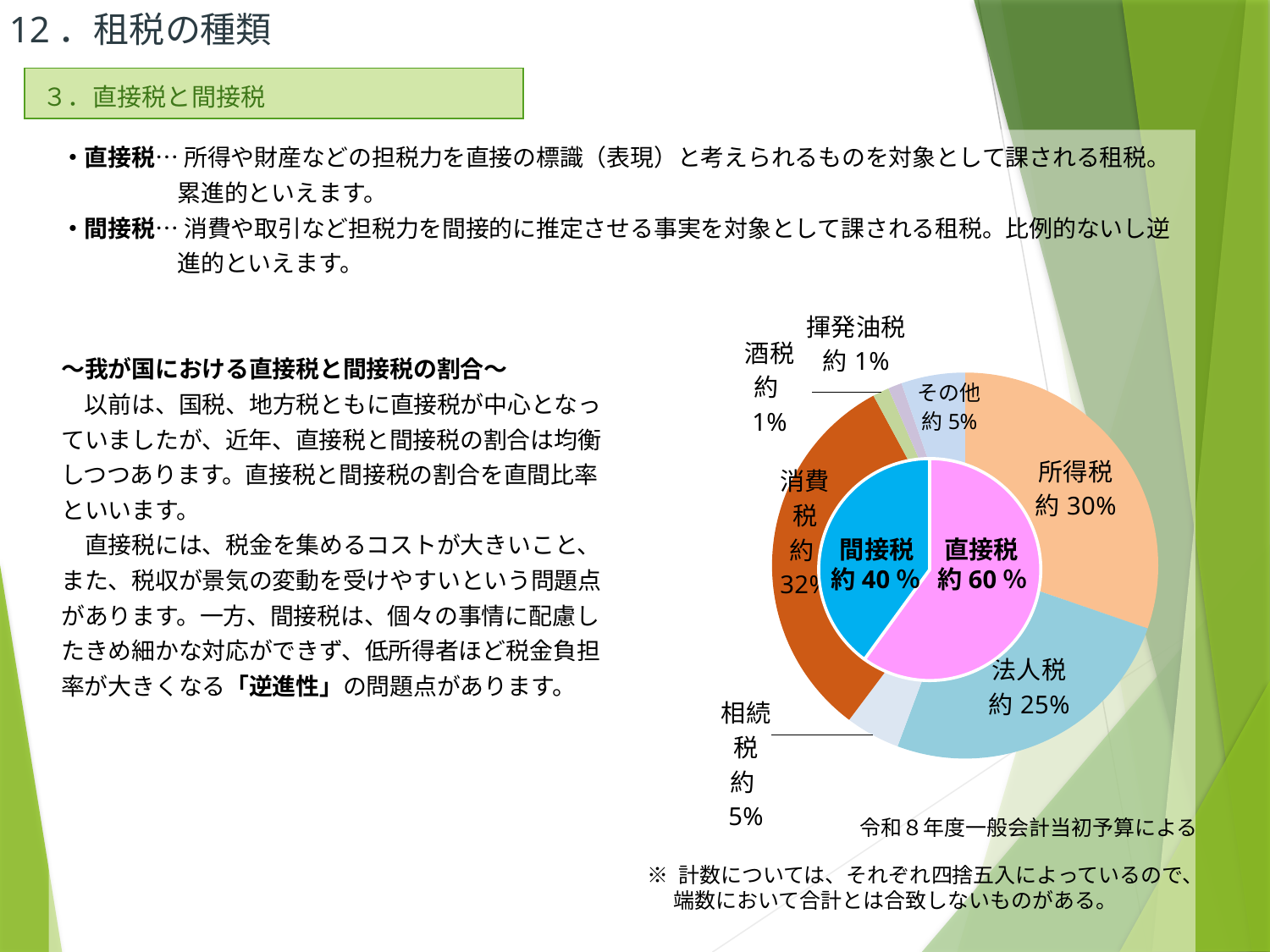
Which category in the outer ring has the largest share? 消費税 What share of the inner ring does 間接税 account for? 約 40％ What is the value shown for 相続税 in the outer ring? 約 5% What is the value shown for 消費税 in the outer ring? 約 32% What kind of chart is shown on the slide? Doughnut (pie) chart What is the value shown for 所得税 in the outer ring? 約 30% What is the difference between the 直接税 and 間接税 shares in the inner ring? 20％ What is the value shown for 法人税 in the outer ring? 約 25% Which is larger in the outer ring, 所得税 or 法人税? 所得税 What share of the inner ring does 直接税 account for? 約 60％ How many categories are labelled in the outer ring of the chart? 7 According to the note below the chart, which budget is the data based on? 令和８年度一般会計当初予算